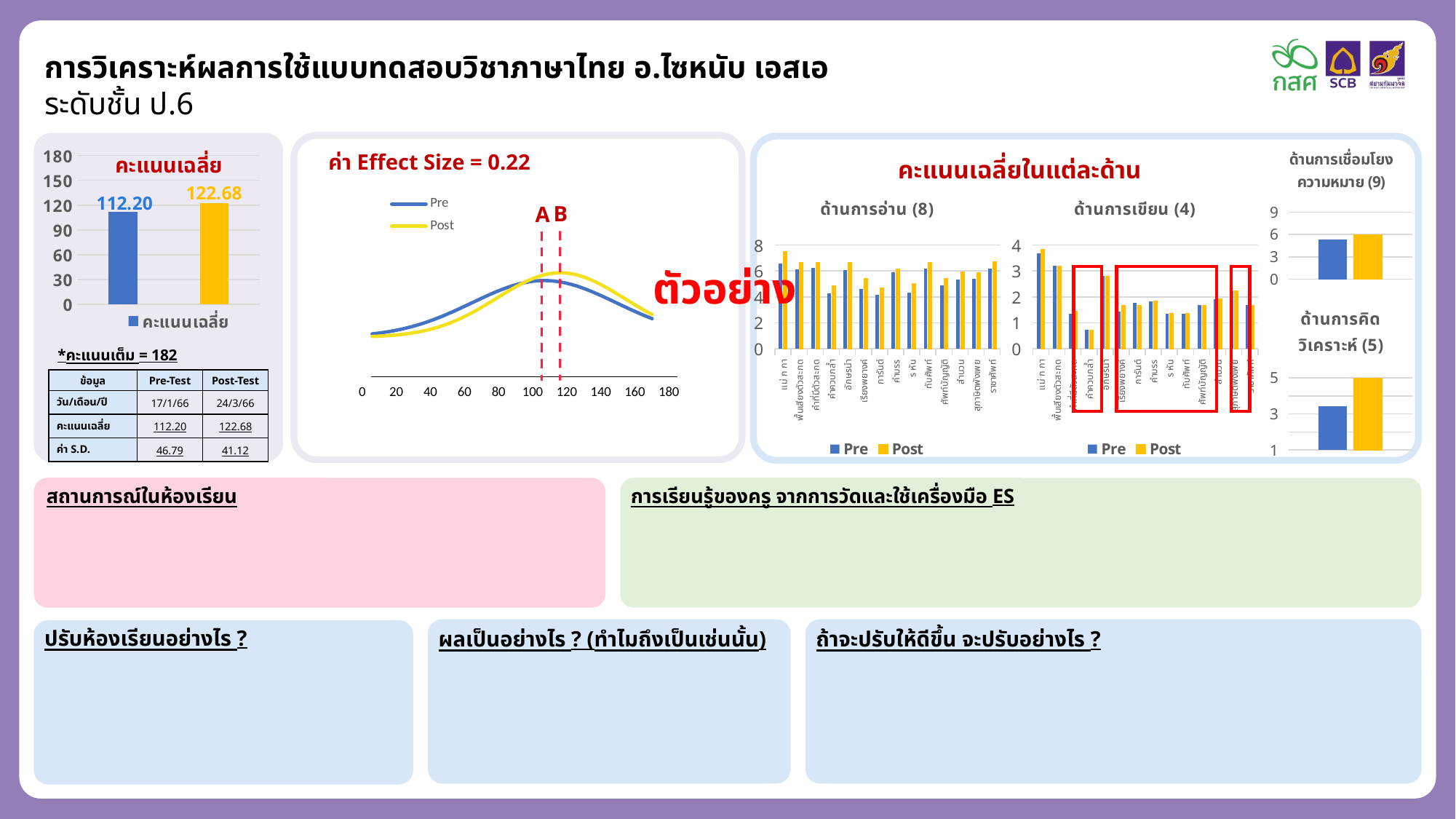
In the ด้านการคิดวิเคราะห์ (5) chart, which bar is taller, Pre or Post? Post In the คะแนนเฉลี่ย bar chart, what is the value of the blue (Pre) bar? 112.20 In the คะแนนเฉลี่ย bar chart, what is the difference between the Post value and the Pre value? 10.48 In the คะแนนเฉลี่ย bar chart, is the Post value greater or less than 150? less What kind of chart is the ค่า Effect Size = 0.22 chart? Line chart In the ด้านการเชื่อมโยงความหมาย (9) chart, is the Post value greater or less than 3? greater In the คะแนนเฉลี่ย bar chart, what is the value of the yellow (Post) bar? 122.68 In the คะแนนเฉลี่ย bar chart, which bar is taller, the blue Pre bar or the yellow Post bar? Post (122.68) What Effect Size value is printed above the line chart? 0.22 In the ด้านการคิดวิเคราะห์ (5) chart, is the Pre value greater or less than 5? less How many series does the legend of the ค่า Effect Size chart list? 2 What kind of chart is the คะแนนเฉลี่ย chart on the left of the slide? Bar chart